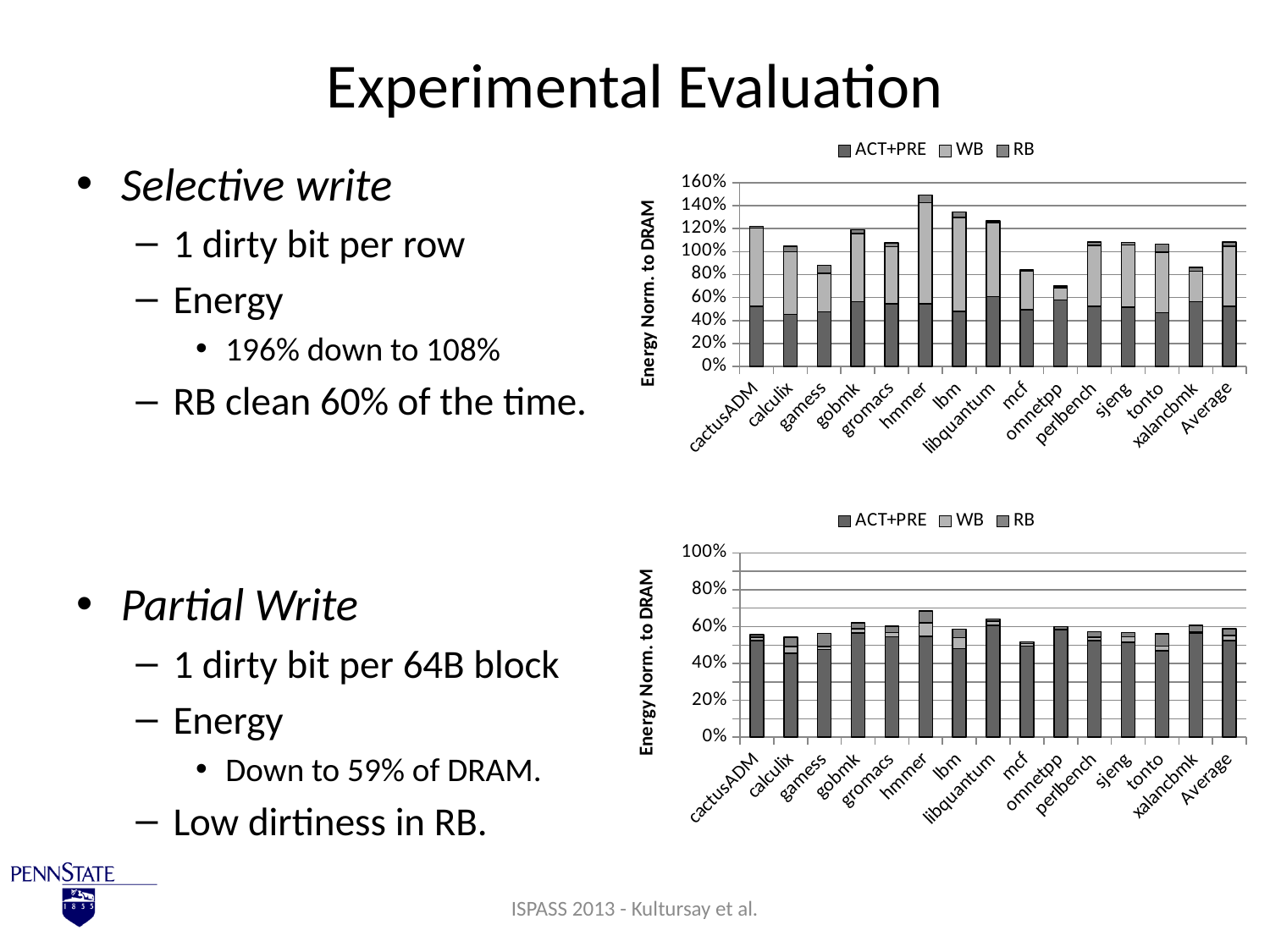
How many categories are shown on the x axis of the top chart? 15 How many series does the legend of the bottom chart list? 3 In the bottom chart, which category has the highest total bar? hmmer In the top chart, is the total value for cactusADM greater or less than 100%? greater What kind of chart is the top chart? stacked bar chart In the top chart, which category has the highest total bar? hmmer In the top chart, which category has the lowest total bar? omnetpp In the top chart, which has the larger total bar, gamess or gobmk? gobmk In the bottom chart, is the total value for hmmer greater or less than 60%? greater In the bottom chart, is the total value for Average greater or less than 80%? less